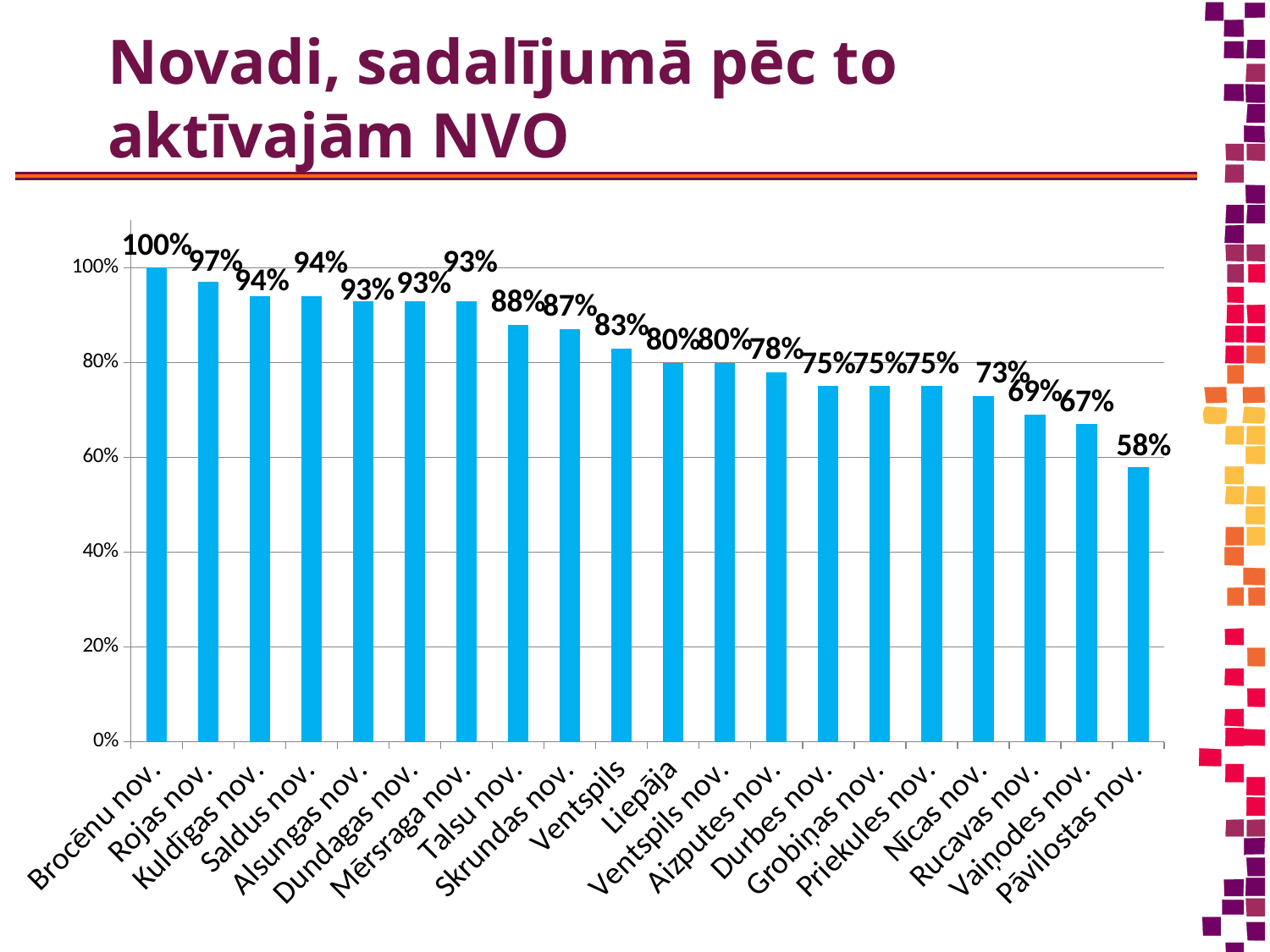
Which is larger, the value for Ventspils or the value for Aizputes nov.? Ventspils What is the value for Pāvilostas nov.? 58% Which category has the lowest value? Pāvilostas nov. What is the value for Talsu nov.? 88% What is the title of the slide? Novadi, sadalījumā pēc to aktīvajām NVO What is the value for Liepāja? 80% Which category has the highest value? Brocēnu nov. What kind of chart is shown on the slide? Bar chart What is the difference between the values for Rojas nov. and Rucavas nov.? 28% How many categories are shown on the x axis? 20 What is the value for Brocēnu nov.? 100% Do the values rise or fall from left to right along the x axis? Fall